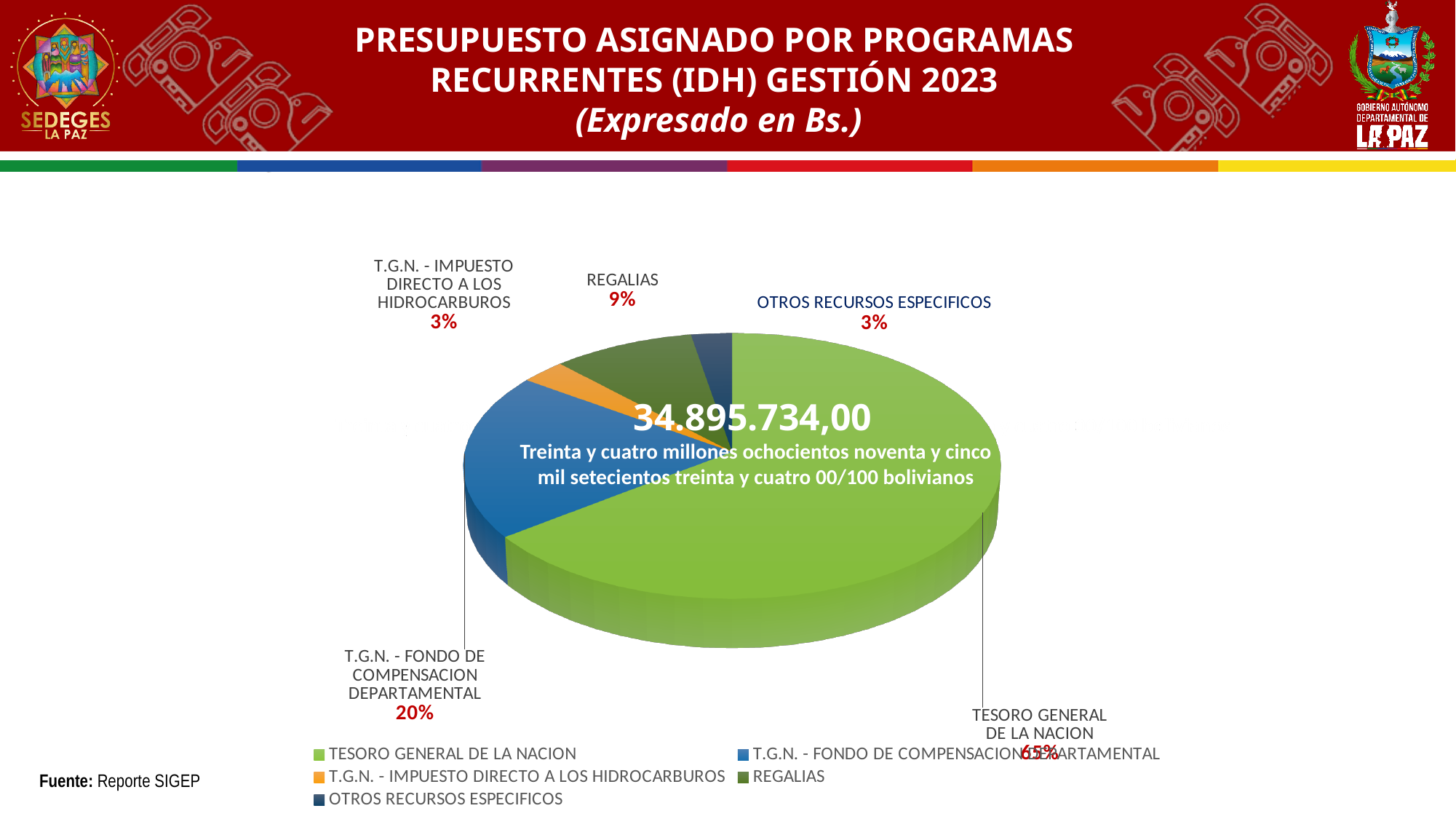
How many slices does the pie chart have? 5 Which category has the largest slice of the pie? TESORO GENERAL DE LA NACION Which is larger, the share for REGALIAS or the share for OTROS RECURSOS ESPECIFICOS? REGALIAS What share of the pie does REGALIAS represent? 9% What is the difference in percentage points between TESORO GENERAL DE LA NACION and T.G.N. - FONDO DE COMPENSACION DEPARTAMENTAL? 45 percentage points What total amount in Bs. is printed in the centre of the pie chart? 34.895.734,00 How many entries does the legend list? 5 What share of the pie does T.G.N. - FONDO DE COMPENSACION DEPARTAMENTAL represent? 20% What kind of chart is shown on the slide? pie chart What colour is the slice for T.G.N. - IMPUESTO DIRECTO A LOS HIDROCARBUROS? orange What share of the pie does TESORO GENERAL DE LA NACION represent? 65%